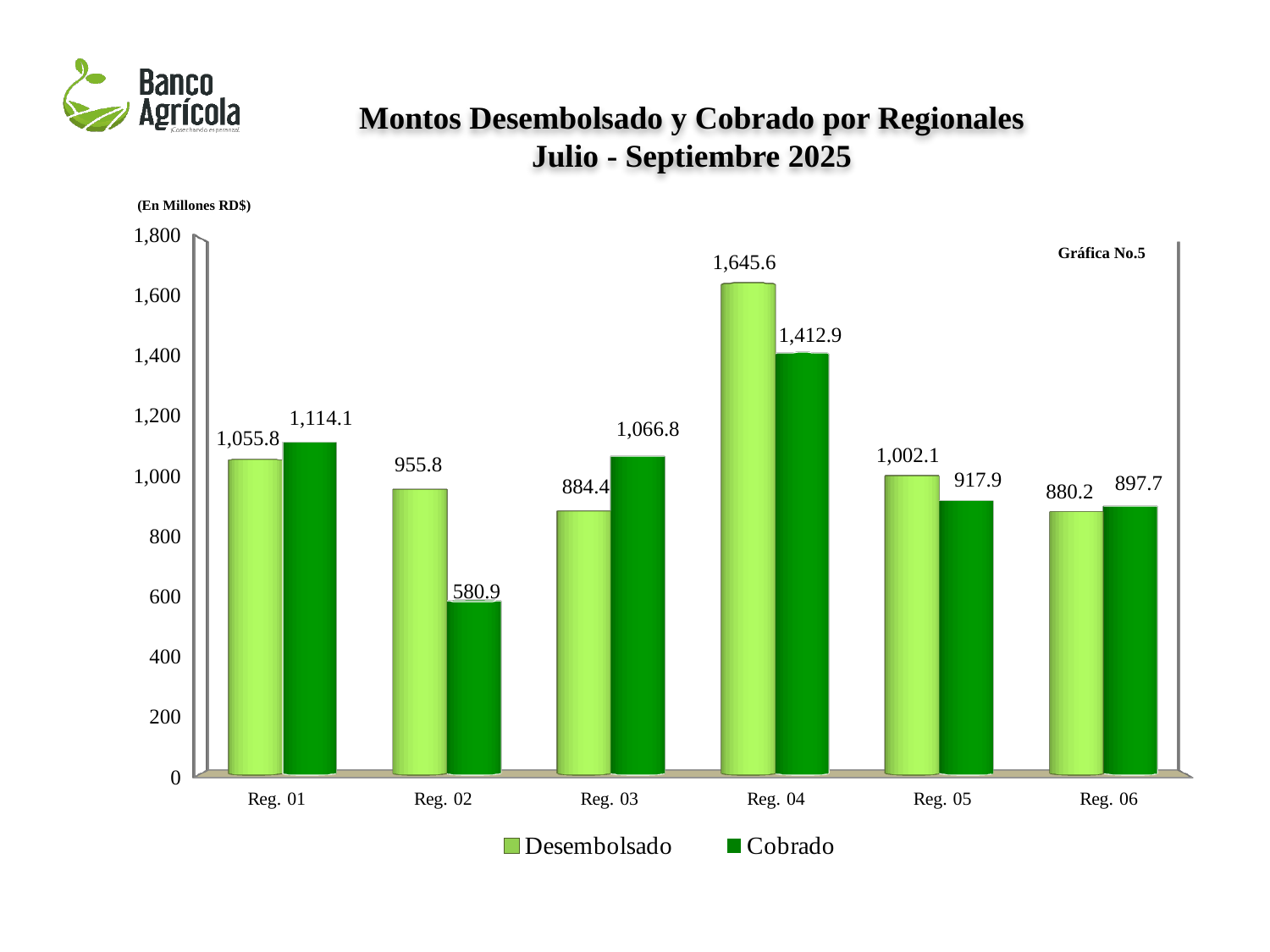
What kind of chart is shown on the slide? bar chart What is the Cobrado value for Reg. 02? 580.9 Is the Cobrado value for Reg. 04 greater or less than 1,200? greater Which region has the lowest Cobrado value? Reg. 02 What is the Desembolsado value for Reg. 01? 1,055.8 What is the difference between the Desembolsado and Cobrado values for Reg. 04? 232.7 What is the Cobrado value for Reg. 03? 1,066.8 Which region has the highest Desembolsado value? Reg. 04 What is the difference between the Desembolsado and Cobrado values for Reg. 02? 374.9 For Reg. 05, which is larger, Desembolsado or Cobrado? Desembolsado How many series does the legend list? 2 How many regions are shown on the x axis? 6